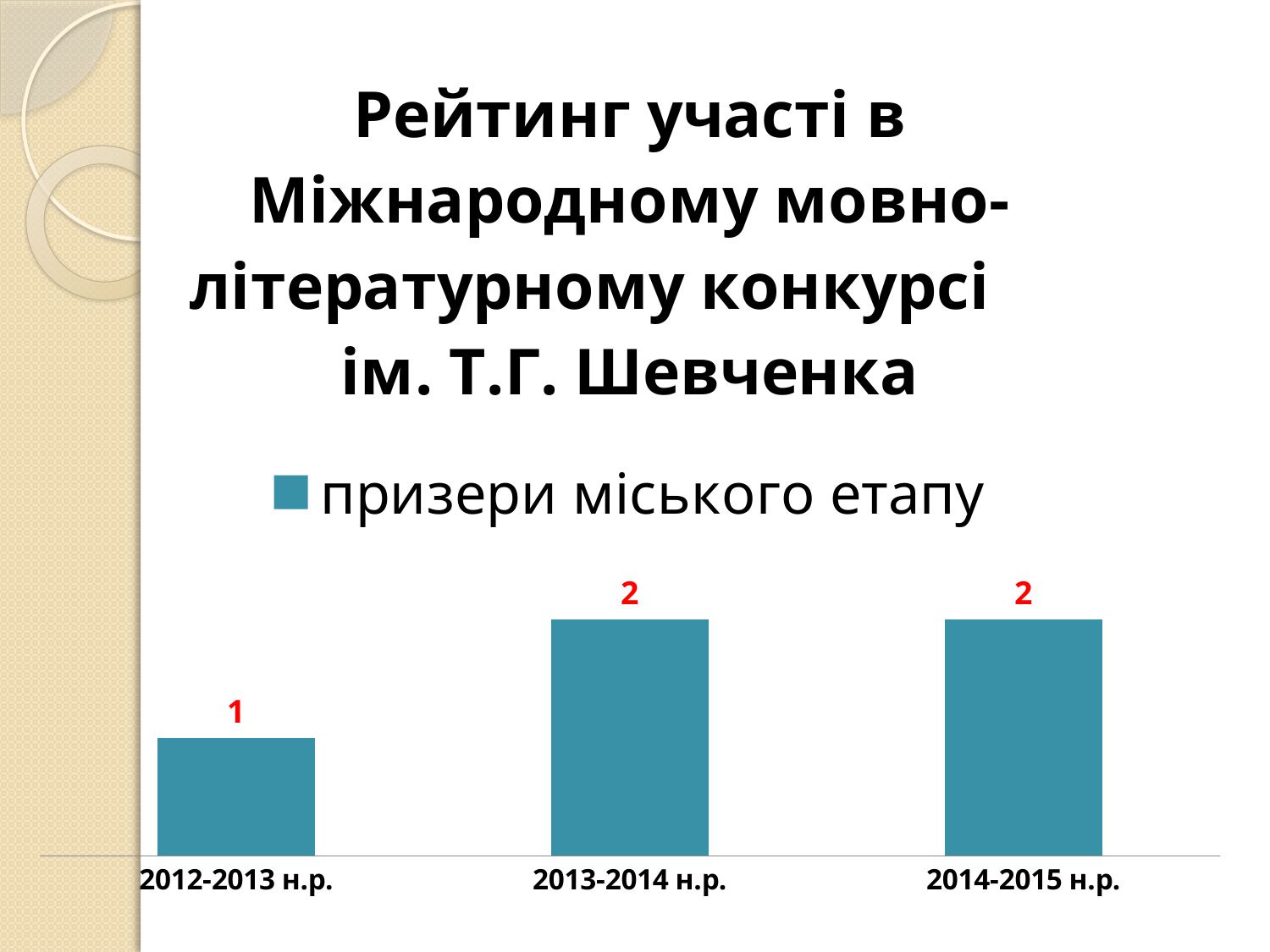
What colour are the bars in the chart? blue What is the value for 2014-2015 н.р.? 2 Do the values rise or fall from 2012-2013 н.р. to 2013-2014 н.р.? rise What is the difference between the values for 2013-2014 н.р. and 2012-2013 н.р.? 1 What is the value for 2012-2013 н.р.? 1 Which is larger, the value for 2012-2013 н.р. or the value for 2014-2015 н.р.? 2014-2015 н.р. How many categories are shown on the x axis? 3 How many series does the legend list? 1 What is the value for 2013-2014 н.р.? 2 Which category has the lowest value? 2012-2013 н.р. What kind of chart is shown on the slide? bar chart What is the name of the series shown in the legend? призери міського етапу